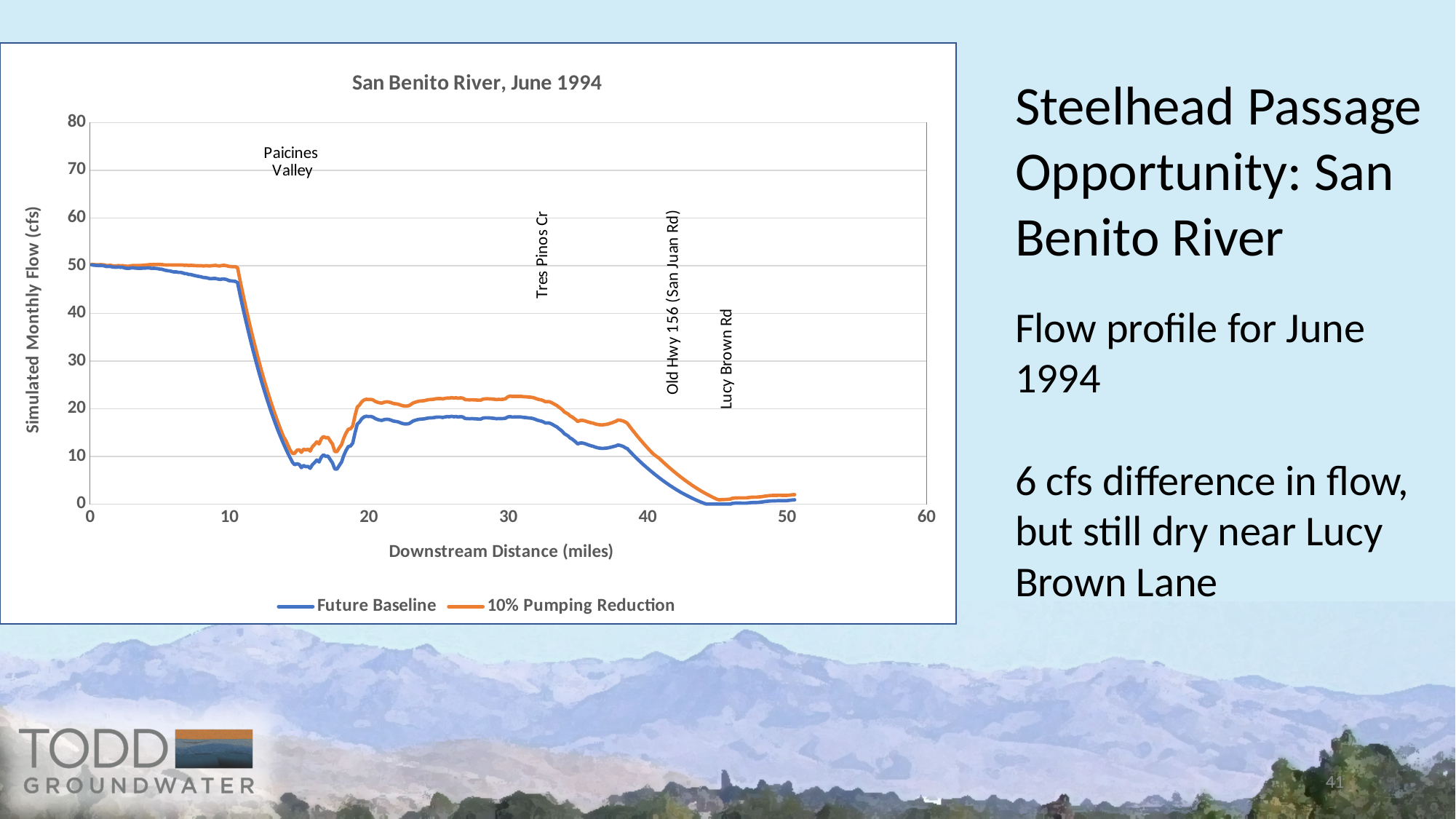
What kind of chart is shown on the slide? line chart Between 40 and 45 miles downstream, does the 10% Pumping Reduction flow rise or fall? fall What is the label of the chart's x axis? Downstream Distance (miles) How many series does the chart's legend list? 2 Is the 10% Pumping Reduction flow at 25 miles downstream greater or less than 10 cfs? greater Between 10 and 15 miles downstream, does the Future Baseline flow rise or fall? fall Is the Future Baseline flow at 5 miles downstream greater or less than 40 cfs? greater At 30 miles downstream, which series shows the higher flow, Future Baseline or 10% Pumping Reduction? 10% Pumping Reduction Is the Future Baseline flow at 30 miles downstream greater or less than 20 cfs? less What is the title of the chart? San Benito River, June 1994